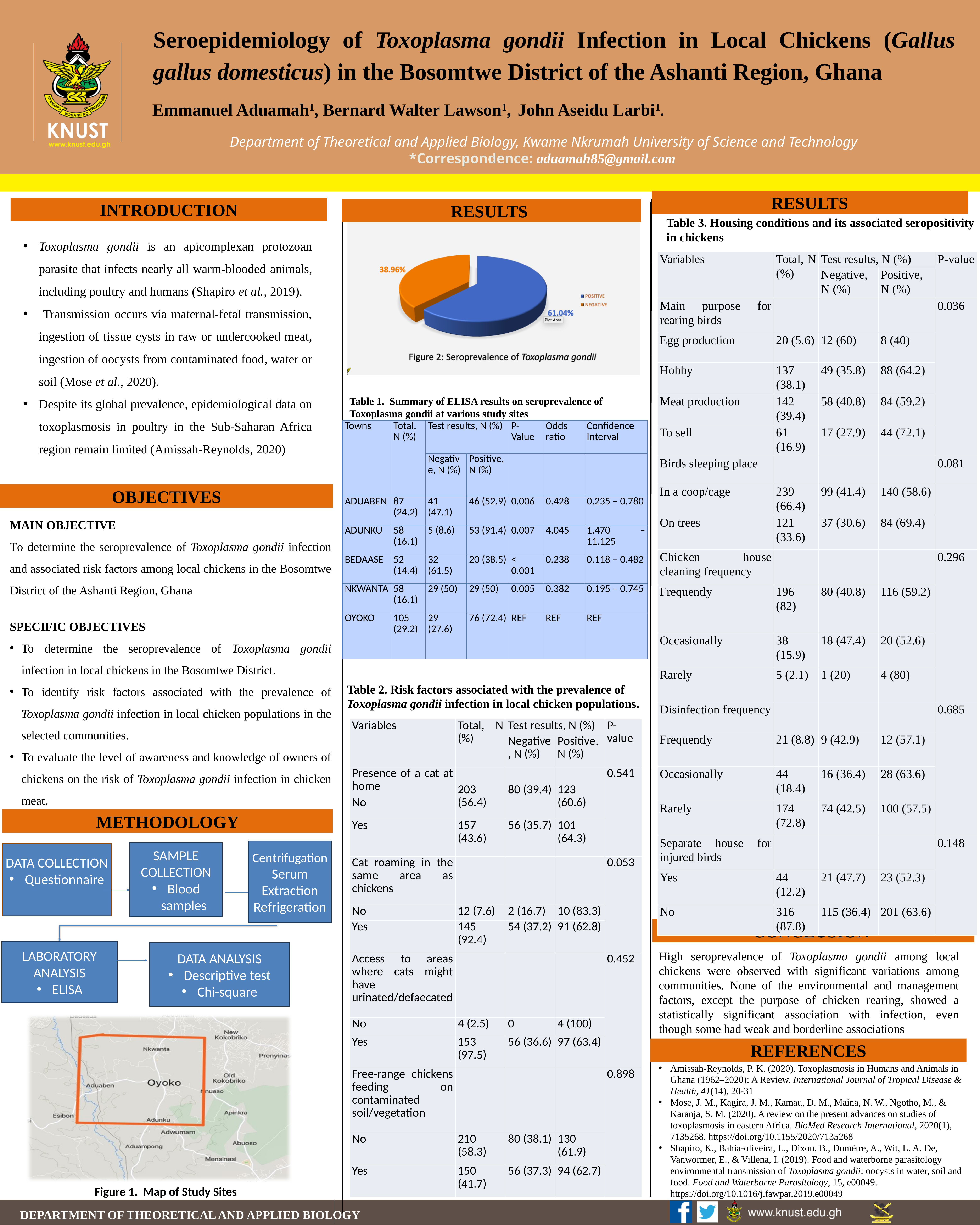
What kind of chart is Figure 2: Seroprevalence of Toxoplasma gondii? pie chart In the pie chart, what share is labelled for NEGATIVE? 38.96% In the pie chart, what share is labelled for POSITIVE? 61.04% In the pie chart, which colour represents the NEGATIVE slice? orange How many slices does the pie chart have? 2 Which slice of the pie chart is the largest? POSITIVE Which slice of the pie chart is the smallest? NEGATIVE What is the caption of the pie chart? Figure 2: Seroprevalence of Toxoplasma gondii Is the POSITIVE share in the pie chart greater or less than 50%? greater In the pie chart, which is larger, the POSITIVE slice or the NEGATIVE slice? POSITIVE How many entries does the legend of the pie chart list? 2 What is the difference in percentage points between the POSITIVE and NEGATIVE slices of the pie chart? 22.08